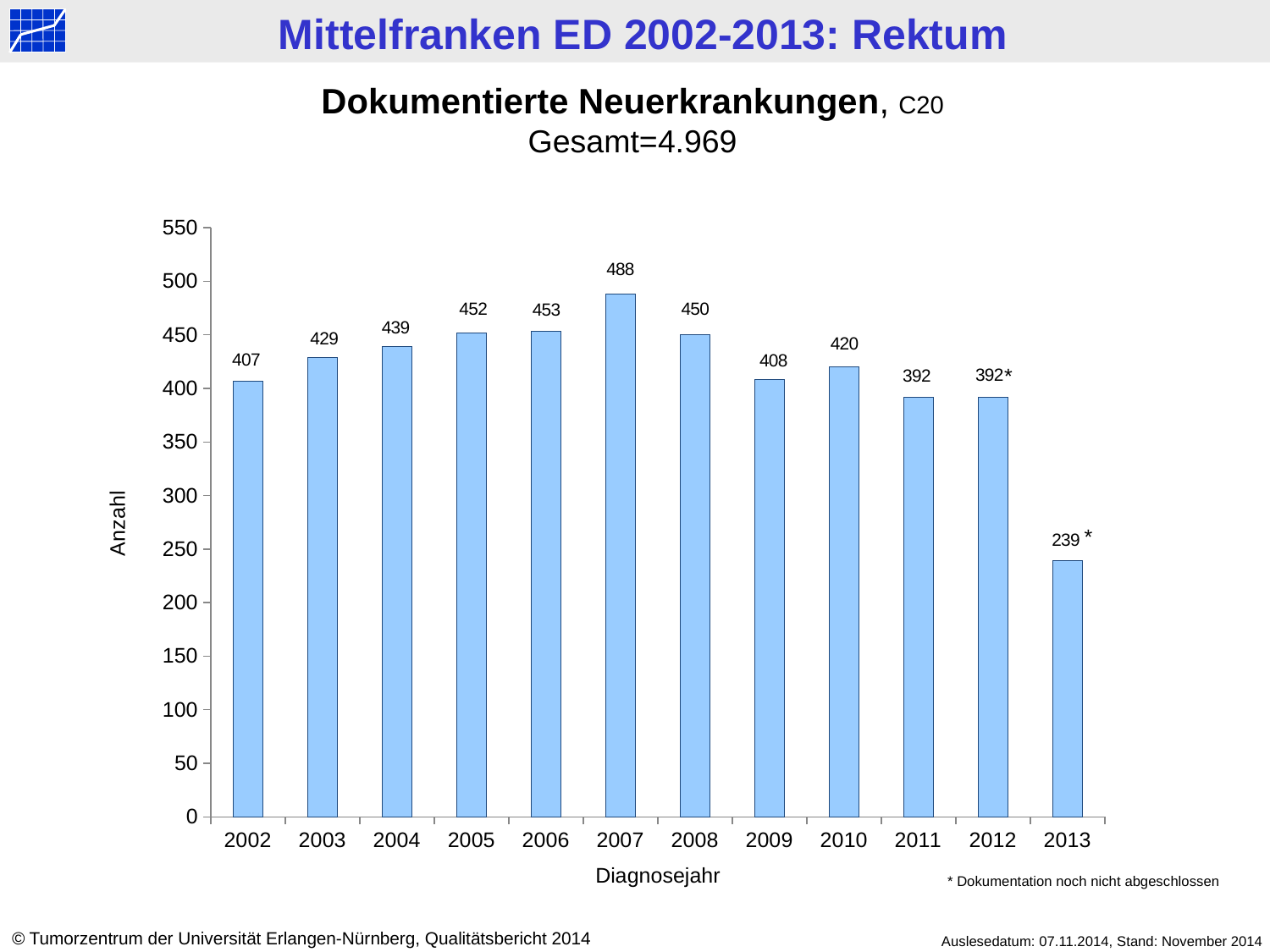
What is the difference between the values for 2005 and 2002? 45 Is the value for 2008 greater or less than 400? greater Which year has the highest number of documented new cases? 2007 How many years are shown on the x axis? 12 What is the value shown for 2013? 239 What is the number of documented new cases for 2007? 488 What kind of chart is shown on the slide? bar chart What is the value shown for 2002? 407 Which year has a larger value, 2010 or 2009? 2010 What is the difference between the values for 2007 and 2013? 249 What is the total number of cases (Gesamt) stated on the slide? 4.969 Which year has the lowest number of documented new cases? 2013